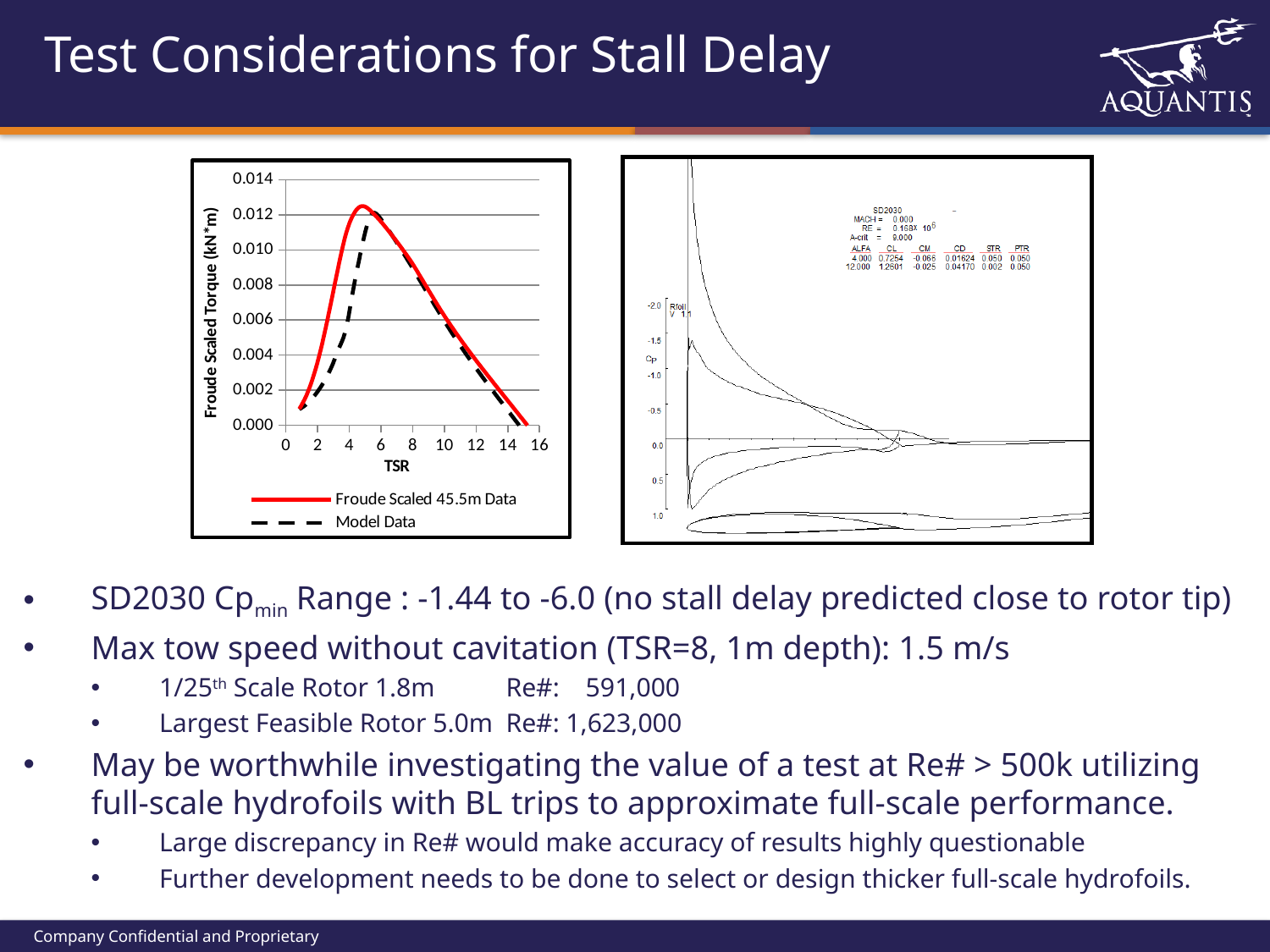
How many series does the legend of the left chart list? 2 What kind of chart is the right chart (Cp distribution)? line chart What kind of chart is the left chart (Froude Scaled Torque vs TSR)? line chart In the right chart, which hydrofoil section is named in the annotation? SD2030 In the left chart, what are the two series named in the legend? Froude Scaled 45.5m Data and Model Data In the right chart, is the most negative Cp value plotted less or greater than -1.5? less In the left chart, at TSR 4, which series has the higher torque value: Froude Scaled 45.5m Data or Model Data? Froude Scaled 45.5m Data In the left chart, is the Model Data value at TSR 4 greater or less than 0.008? less In the left chart, what is the label of the y axis? Froude Scaled Torque (kN*m) In the left chart, is the peak value of the Froude Scaled 45.5m Data series greater or less than 0.010? greater In the left chart, do the torque values rise or fall as TSR increases from 1 to 4? rise In the left chart, do the torque values rise or fall as TSR increases from 6 to 14? fall